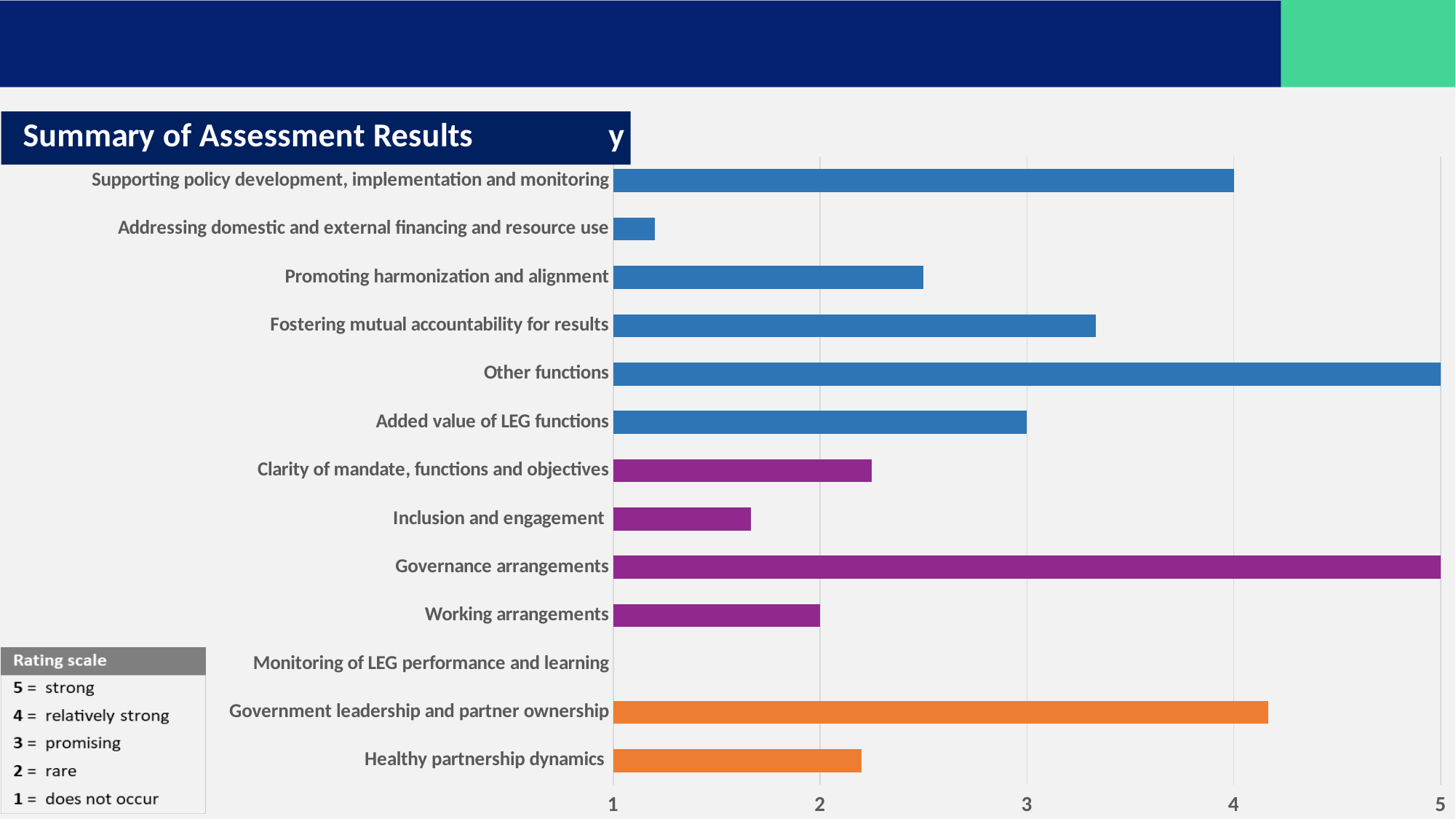
What kind of chart is shown on the slide? bar chart What is the value for Other functions? 5 What is the value for Governance arrangements? 5 What is the value for Added value of LEG functions? 3 Which is larger, the value for Government leadership and partner ownership or the value for Healthy partnership dynamics? Government leadership and partner ownership What is the title of the chart? Summary of Assessment Results Is the value for Fostering mutual accountability for results greater or less than 3? greater Is the value for Government leadership and partner ownership greater or less than 4? greater How many categories are listed on the chart's vertical axis? 13 What is the difference between the values for Other functions and Working arrangements? 3 What is the value for Working arrangements? 2 Is the value for Inclusion and engagement greater or less than 2? less